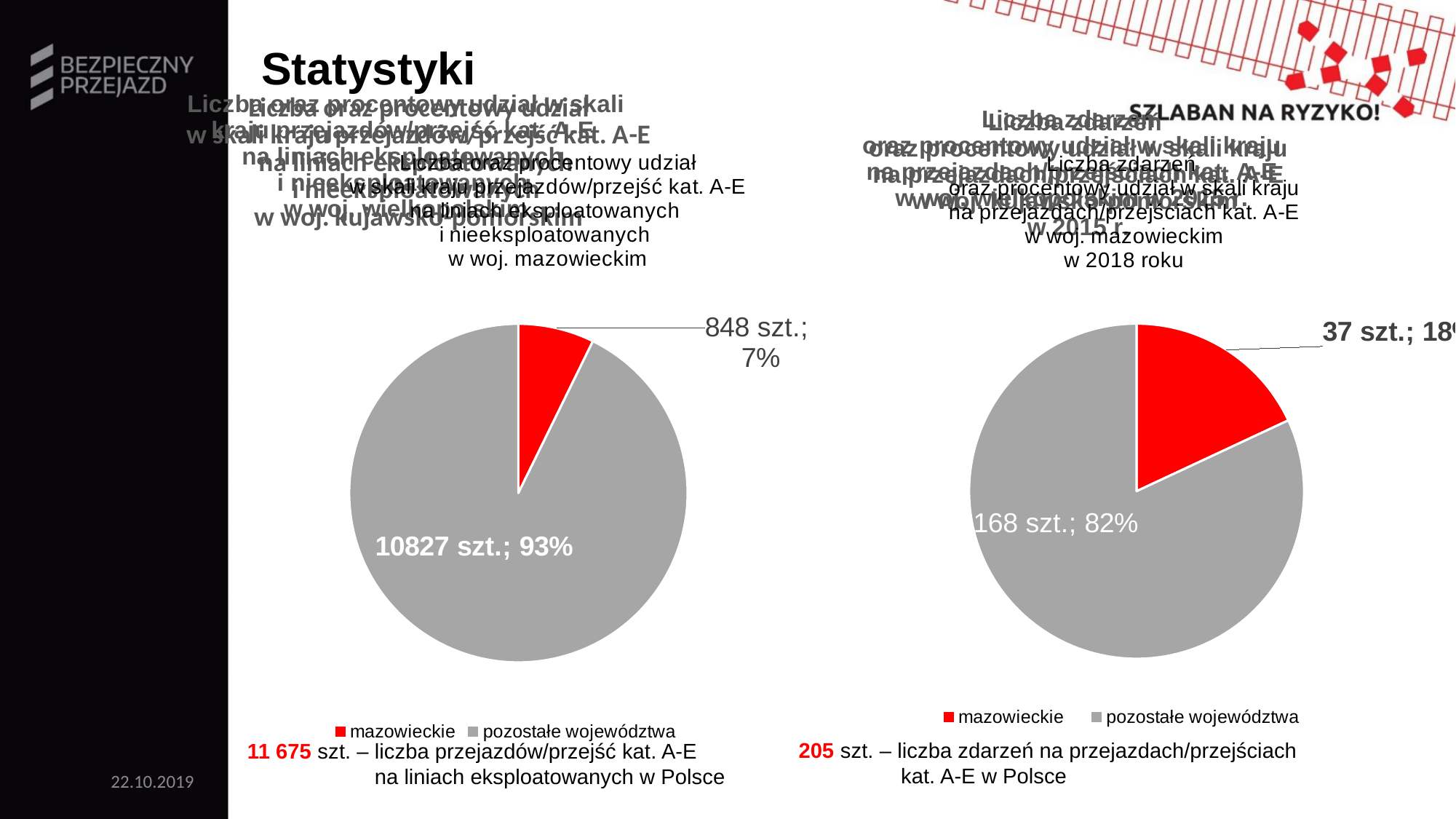
In the left pie chart, what value is shown for the 'mazowieckie' slice? 848 szt.; 7% In the right pie chart, which slice is the smallest? mazowieckie In the right pie chart, what value is shown for the 'pozostałe województwa' slice? 168 szt.; 82% What kind of chart is the left chart on the slide? pie chart In the left pie chart, which slice is the largest? pozostałe województwa In the left pie chart, what share of the pie does 'mazowieckie' represent? 7% In the right pie chart, how many szt. are shown for the 'mazowieckie' slice? 37 szt. In the right pie chart, what colour is the 'mazowieckie' slice? red How many slices does the left pie chart have? 2 How many entries does the legend of the right pie chart list? 2 In the left pie chart, what is the difference in szt. between 'pozostałe województwa' and 'mazowieckie'? 9979 szt. In the left pie chart, what value is shown for the 'pozostałe województwa' slice? 10827 szt.; 93%